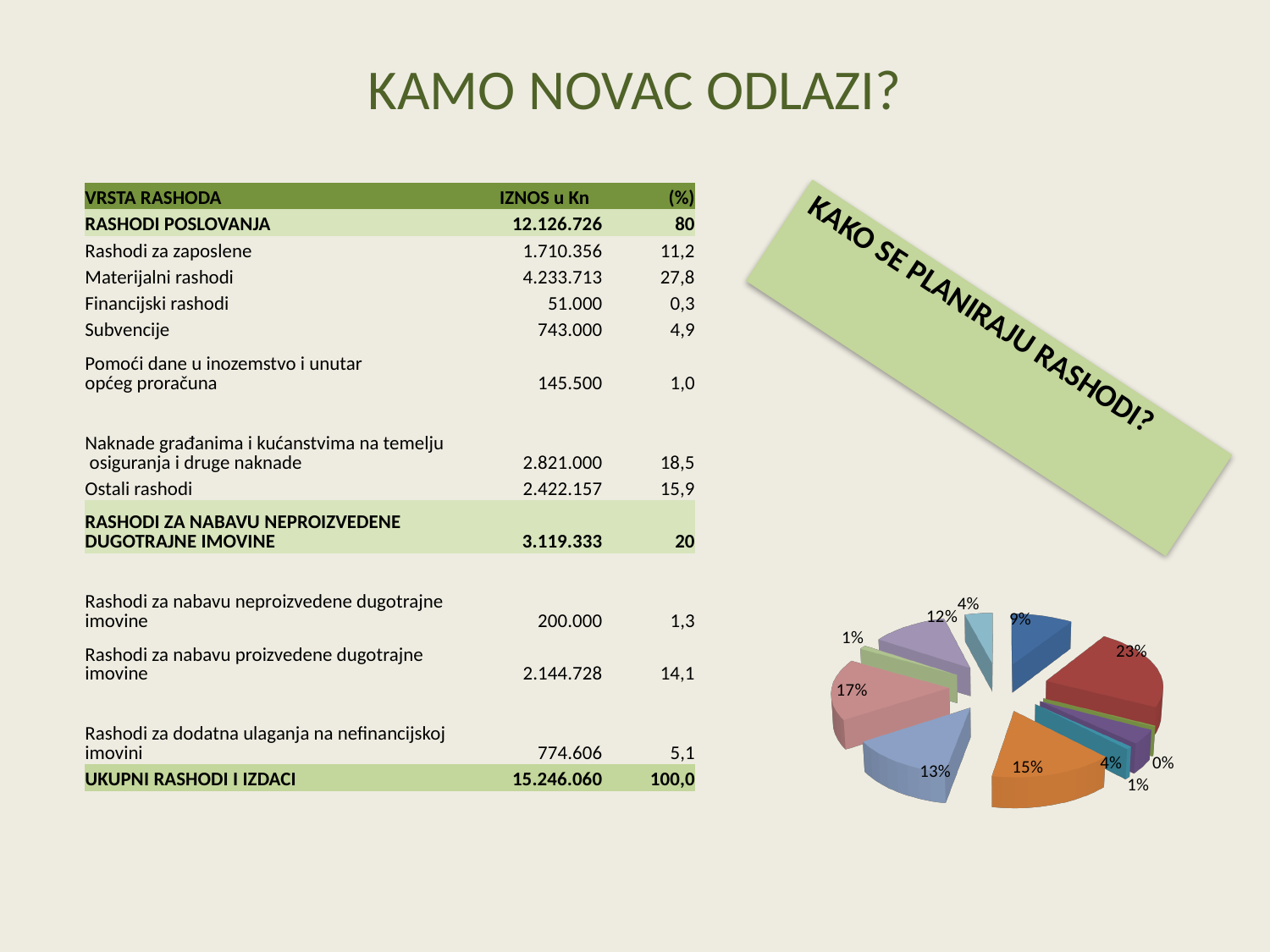
What is the difference in percentage points between the 23% slice and the 15% slice on the pie chart? 8 Which is larger on the pie chart, the slice labelled 23% or the slice labelled 15%? 23% How many slices on the pie chart are labelled 4%? 2 What kind of chart is shown on the slide? pie chart Does the pie chart have a legend? No What is the largest percentage labelled on the pie chart? 23% What is the smallest percentage labelled on the pie chart? 0% How many slices on the pie chart are labelled 1%? 2 How many slices does the pie chart have? 11 What is the difference in percentage points between the 17% slice and the 13% slice on the pie chart? 4 What colour is the largest slice (23%) of the pie chart? red What is the second-largest percentage labelled on the pie chart? 17%